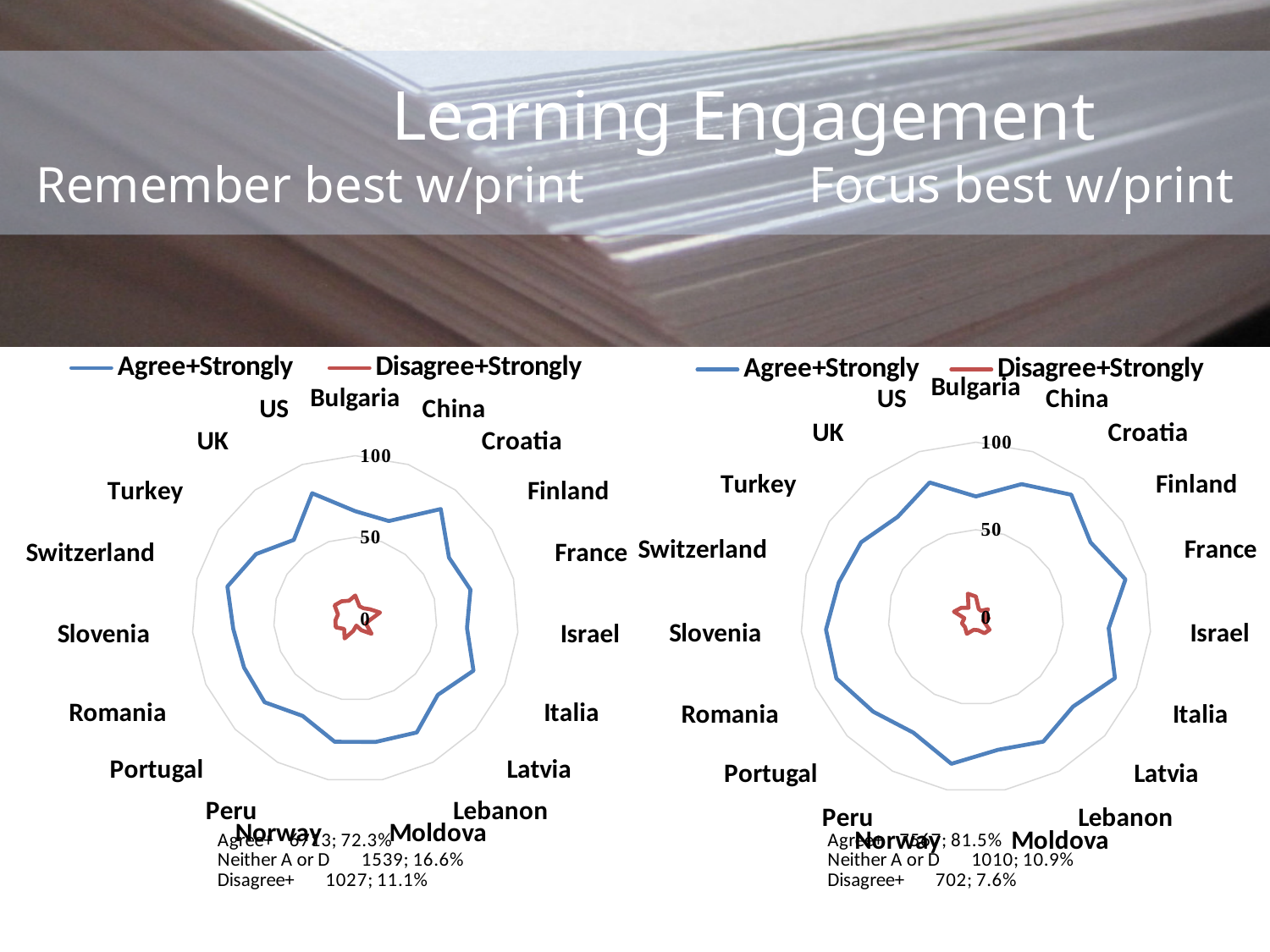
In the 'Remember best w/print' chart on the left, is the Disagree+Strongly value for Israel greater or less than 50? less In the 'Focus best w/print' chart on the right, is the Disagree+Strongly value for Latvia greater or less than 50? less What kind of chart is the 'Remember best w/print' chart on the left? Radar chart In the 'Focus best w/print' chart on the right, which series has the larger value for Romania, Agree+Strongly or Disagree+Strongly? Agree+Strongly What colour is the Disagree+Strongly series in the 'Remember best w/print' chart on the left? Red How many series does the legend of the 'Focus best w/print' chart on the right list? 2 In the 'Focus best w/print' chart on the right, is the Agree+Strongly value for Slovenia greater or less than 50? greater In the 'Remember best w/print' chart on the left, which series has the larger value for Italia, Agree+Strongly or Disagree+Strongly? Agree+Strongly How many countries are plotted around the 'Remember best w/print' chart on the left? 19 What is the highest value shown on the axis of the 'Focus best w/print' chart on the right? 100